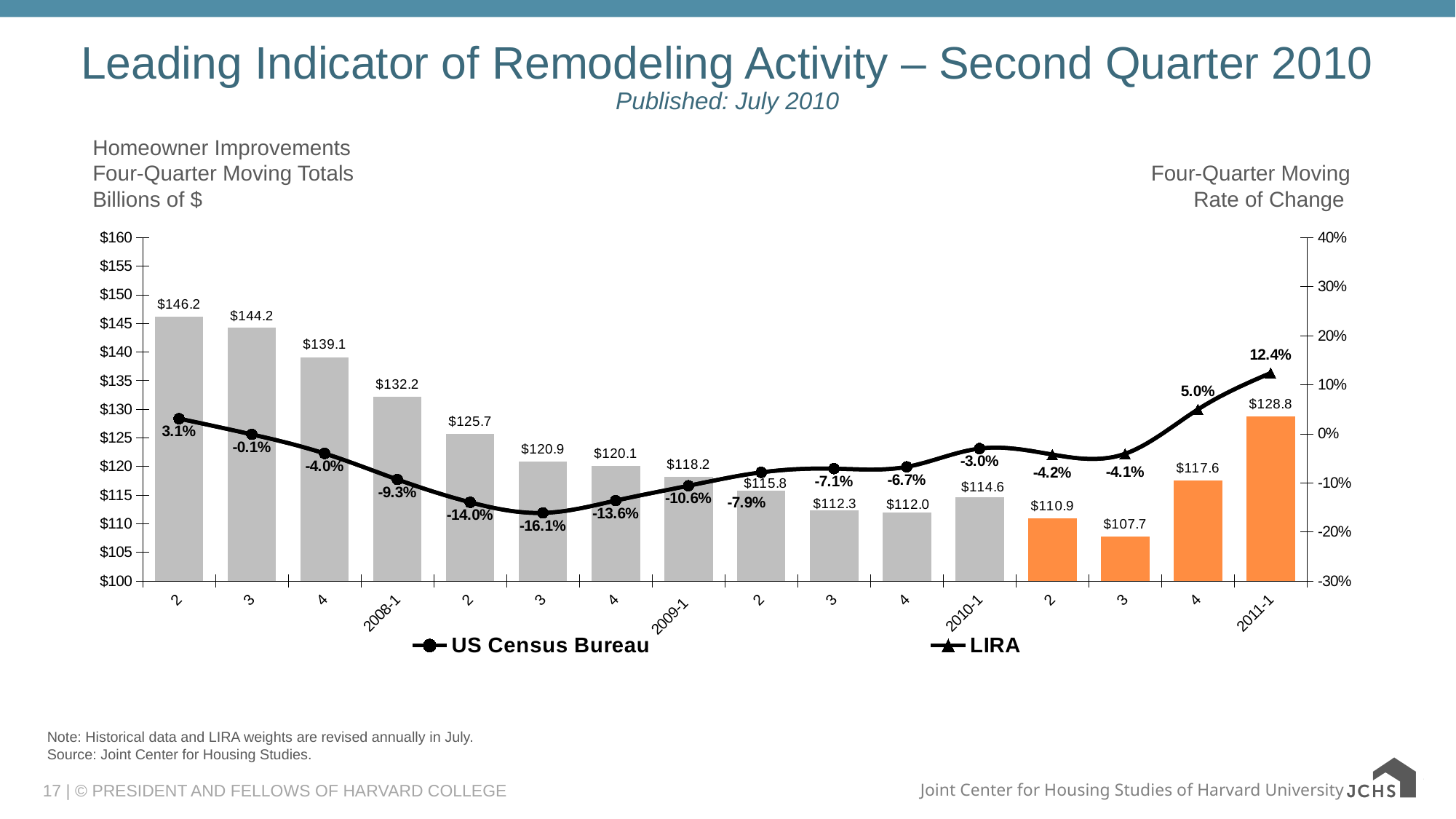
What is the LIRA rate of change at 2011-1? 12.4% How many bars are plotted on the chart? 16 What is the lowest rate of change shown on the US Census Bureau line? -16.1% What is the four-quarter moving total for 2008-1? $132.2 How many series does the legend list? 2 What is the four-quarter moving total shown for 2011-1? $128.8 What colour are the last four bars on the chart? Orange What is the lowest four-quarter moving total shown by any bar? $107.7 How much larger is the four-quarter moving total for 2011-1 than for 2010-1? $14.2 What is the highest four-quarter moving total shown by any bar? $146.2 Which has the larger four-quarter moving total, 2009-1 or 2010-1? 2009-1 What is the US Census Bureau rate of change at 2010-1? -3.0%